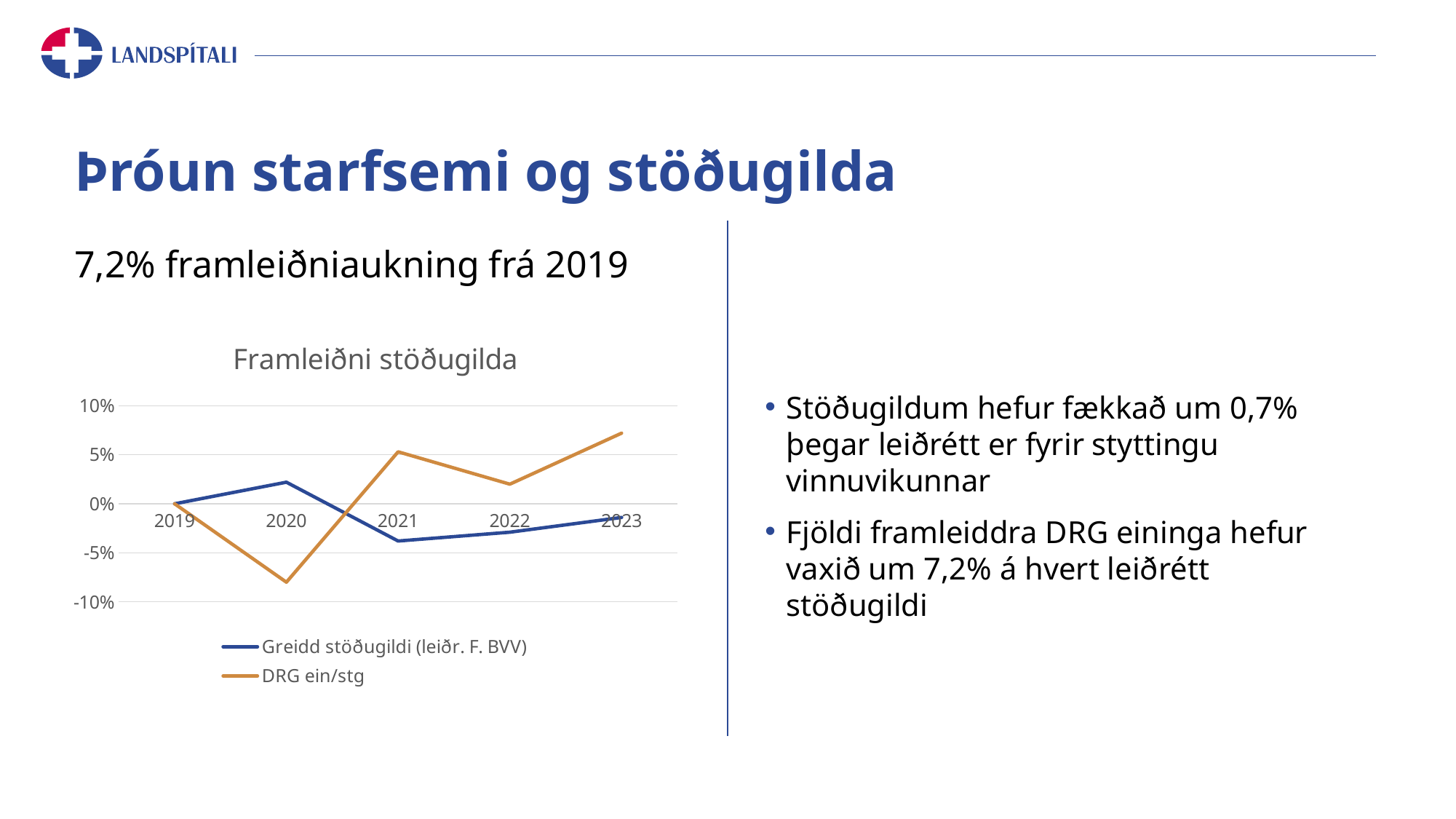
In which year is the DRG ein/stg line at its lowest? 2020 What kind of chart is shown on the slide? line chart Is the value for DRG ein/stg in 2020 greater or less than -5%? less Does the DRG ein/stg line rise or fall from 2022 to 2023? rise In 2022, which series has the higher value: Greidd stöðugildi (leiðr. F. BVV) or DRG ein/stg? DRG ein/stg What is the title of the chart? Framleiðni stöðugilda How many years are plotted along the x axis of the chart? 5 Which series is drawn in orange in the chart? DRG ein/stg In which year is the DRG ein/stg line at its highest? 2023 Is the value for Greidd stöðugildi (leiðr. F. BVV) in 2021 greater or less than 0%? less How many series does the chart's legend list? 2 Is the value for DRG ein/stg in 2023 greater or less than 5%? greater